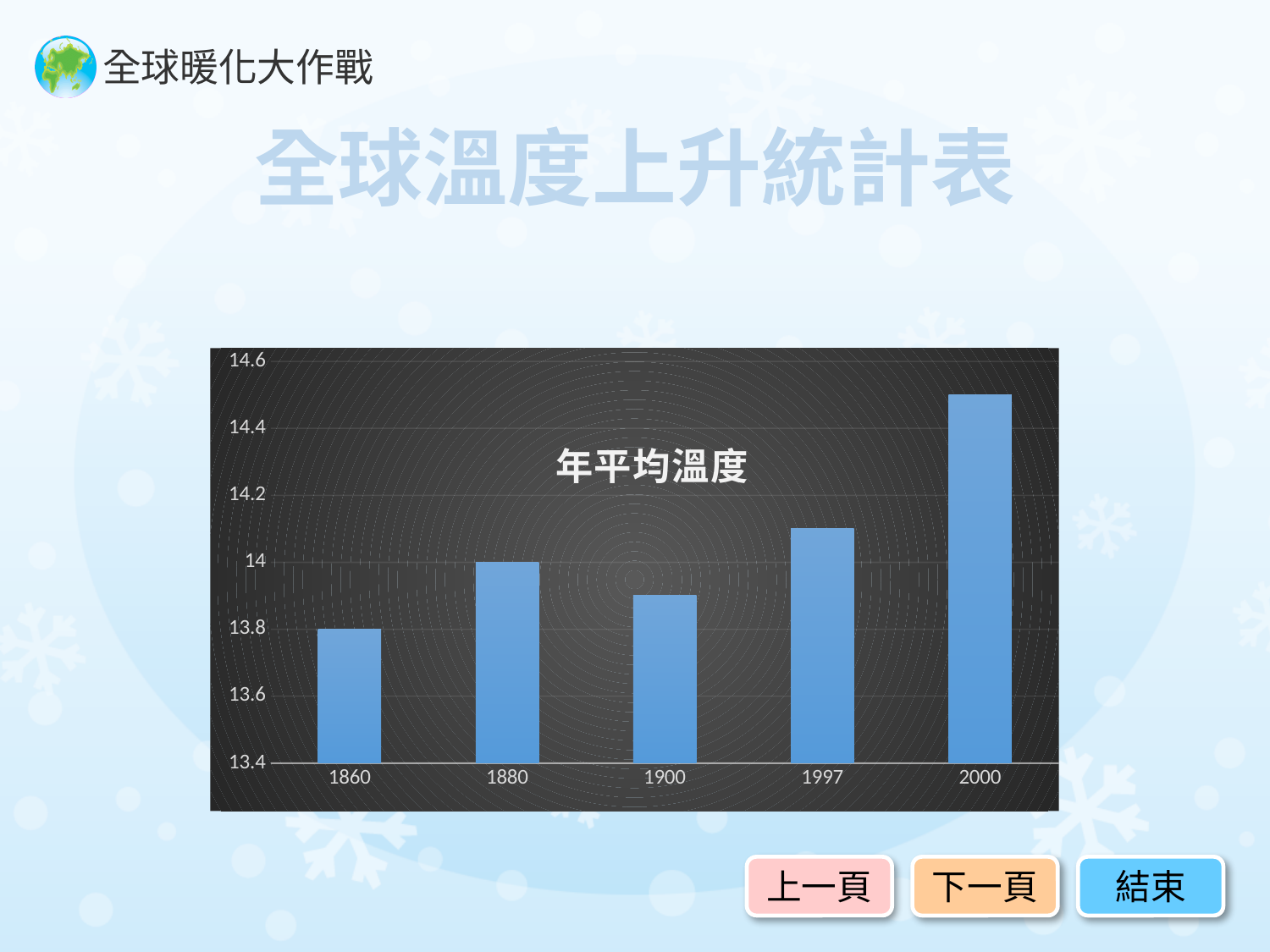
How many years (categories) are plotted on the x axis? 5 Which is larger, the value for 1880 or the value for 1900? 1880 Which year has the highest bar? 2000 Which is larger, the value for 1997 or the value for 1860? 1997 What is the difference between the values for 1880 and 1860? 0.2 Is the value for 1997 greater or less than 14? greater Is the value for 2000 greater or less than 14.4? greater What kind of chart is shown on the slide? bar chart Which year has the lowest bar? 1860 What is the value for 1880? 14 What is the value for 1860? 13.8 What is the title shown inside the chart? 年平均溫度